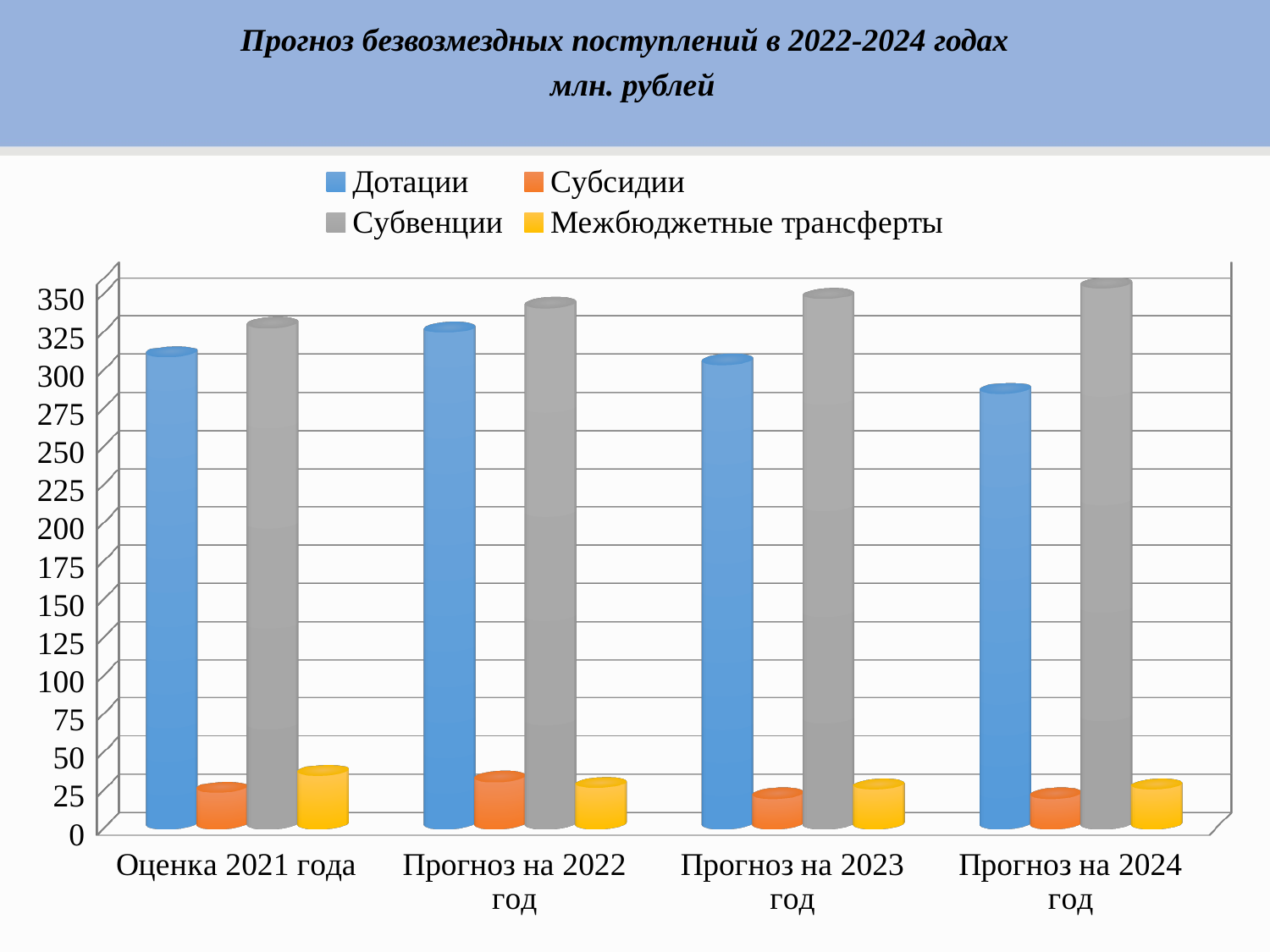
Is the value for Субсидии in 'Оценка 2021 года' greater or less than 50? less How many categories are shown along the x axis? 4 Which series has the highest value in the 'Оценка 2021 года' category? Субвенции Is the value for Дотации in 'Прогноз на 2024 год' greater or less than 300? less Which is larger: Дотации in 'Прогноз на 2022 год' or Дотации in 'Прогноз на 2024 год'? Прогноз на 2022 год How many series does the legend list? 4 What kind of chart is shown on the slide? bar chart Do the values for Субвенции rise or fall from 'Оценка 2021 года' to 'Прогноз на 2024 год'? rise Which is larger in 'Оценка 2021 года': Субсидии or Межбюджетные трансферты? Межбюджетные трансферты Is the value for Субвенции in 'Прогноз на 2024 год' greater or less than 300? greater What is the title of the chart? Прогноз безвозмездных поступлений в 2022-2024 годах млн. рублей Which series has the highest value in the 'Прогноз на 2024 год' category? Субвенции